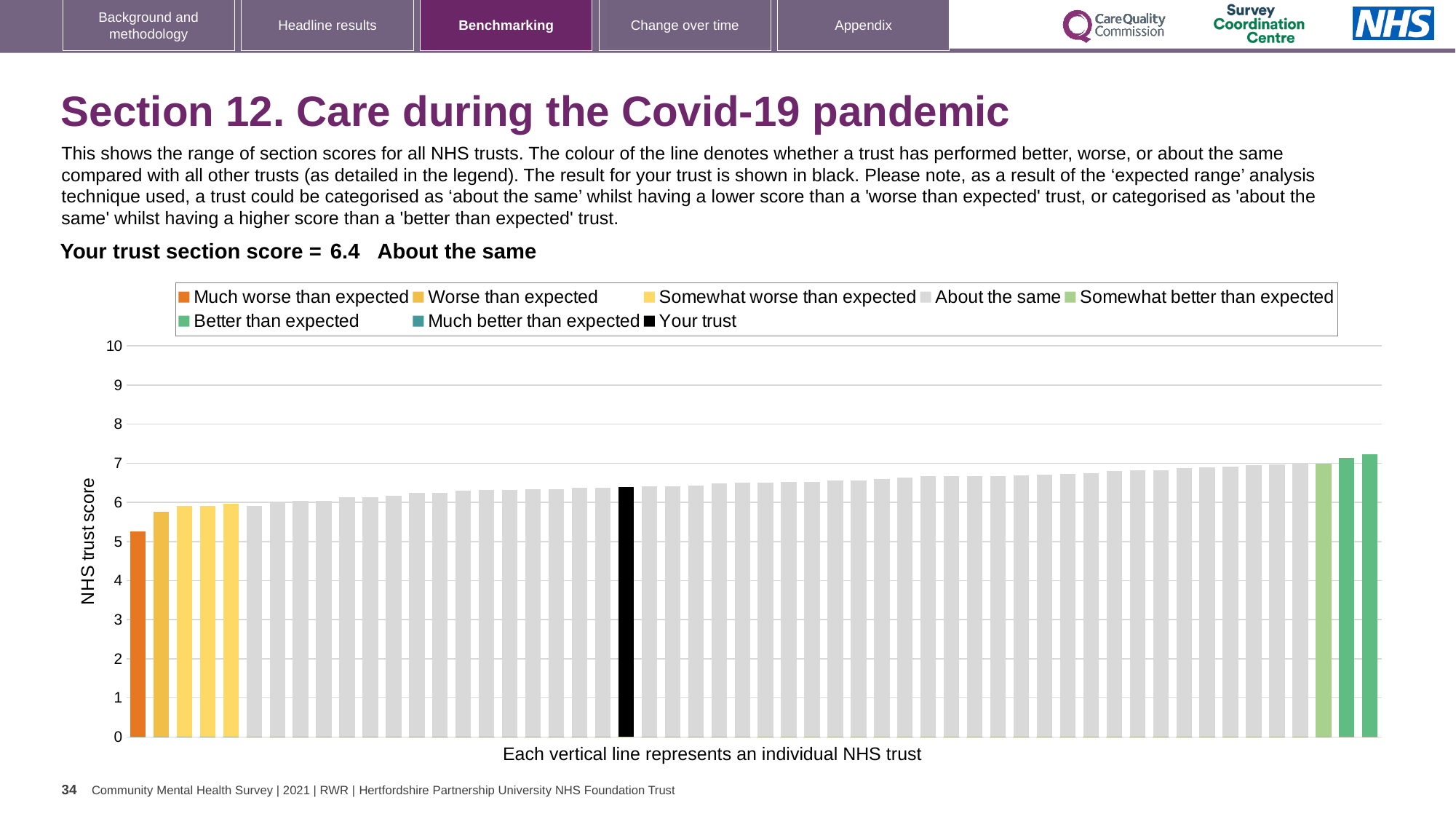
Do the bar values rise or fall moving from left to right along the x axis? rise Is the value of the orange bar greater or less than 5? greater How many bars on the chart are coloured orange (Much worse than expected)? 1 Is the value of the highest bar on the chart greater or less than 7? greater Is the value of the lowest bar (the orange one) greater or less than 6? less How many entries does the chart legend list? 8 What kind of chart is shown on the slide? bar chart What is the section score for your trust shown on the slide? 6.4 Which category is your trust placed in according to the text above the chart? About the same What is the label on the vertical axis of the chart? NHS trust score